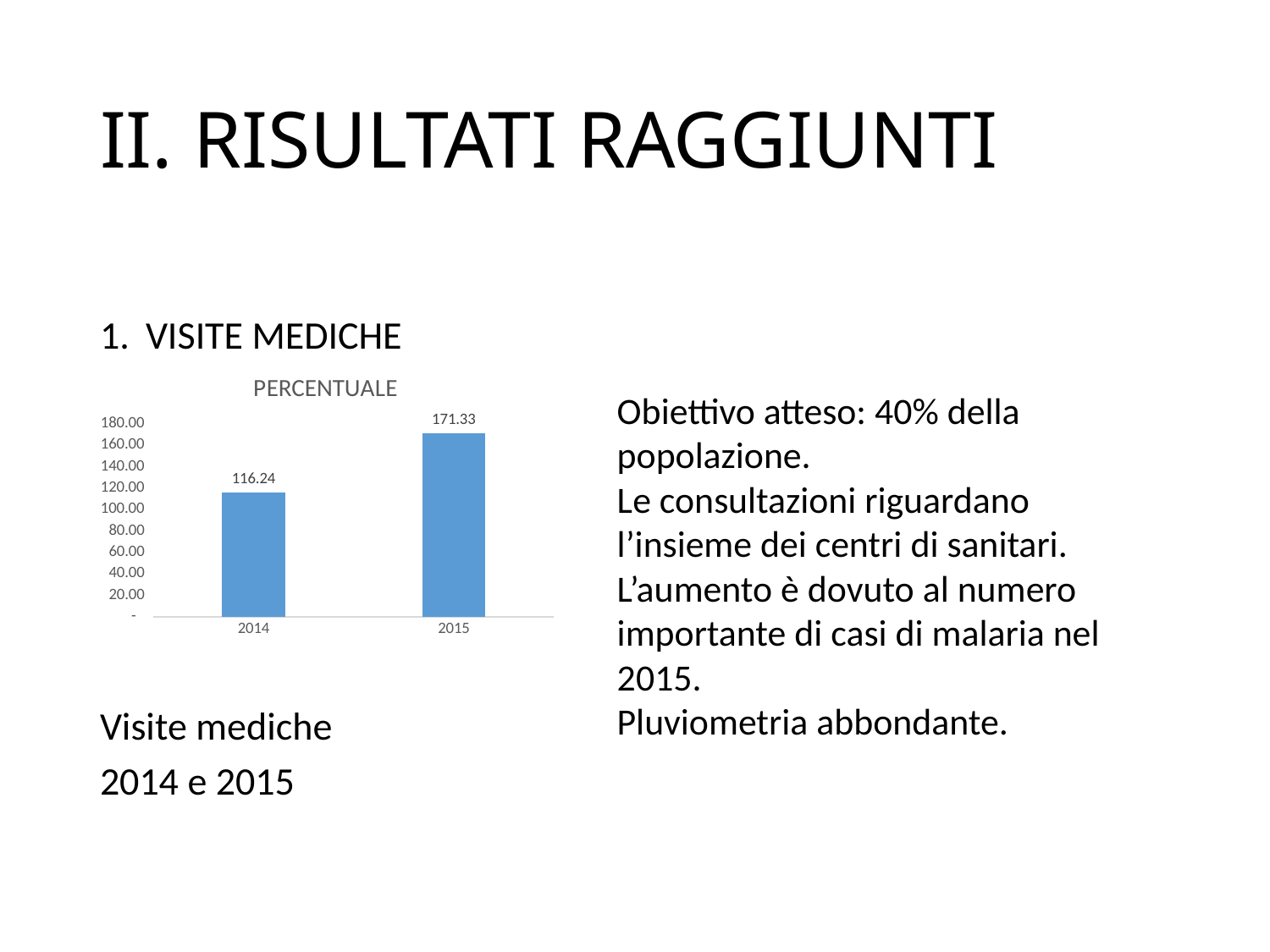
What is the value for 2015 in the PERCENTUALE chart? 171.33 Is the value for 2015 greater or less than 180.00 in the PERCENTUALE chart? less What is the value for 2014 in the PERCENTUALE chart? 116.24 Is the value for 2015 larger or smaller than the value for 2014 in the PERCENTUALE chart? larger Which year has the highest value in the PERCENTUALE chart? 2015 Do the values in the PERCENTUALE chart rise or fall from 2014 to 2015? rise What kind of chart is the PERCENTUALE chart? bar chart Which year has the lowest value in the PERCENTUALE chart? 2014 What is the title of the chart on the slide? PERCENTUALE Is the value for 2014 greater or less than 100.00 in the PERCENTUALE chart? greater How many years are shown on the x axis of the PERCENTUALE chart? 2 What is the difference between the 2015 and 2014 values in the PERCENTUALE chart? 55.09